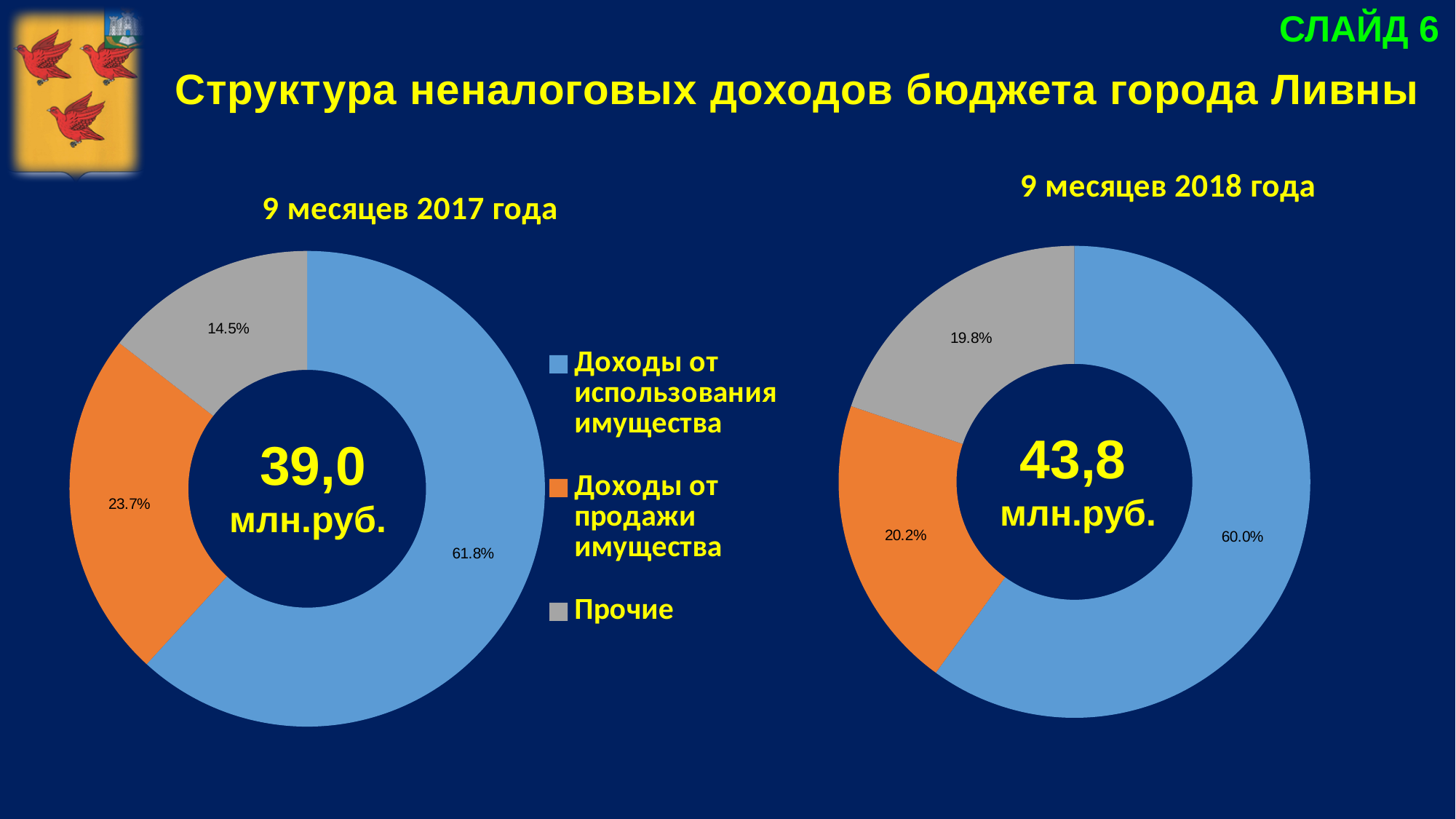
Which is larger: the share of "Прочие" in the 2017 chart or in the 2018 chart? 2018 In the chart for "9 месяцев 2018 года", what share is labelled for "Прочие"? 19.8% In the chart for "9 месяцев 2017 года", which category has the largest share? Доходы от использования имущества What total value is shown in the centre of the chart for "9 месяцев 2018 года"? 43,8 млн.руб. In the chart for "9 месяцев 2018 года", which category has the smallest share? Прочие In the chart for "9 месяцев 2018 года", what share is labelled for "Доходы от продажи имущества"? 20.2% How many categories does the legend list? 3 What type of chart is used on this slide? Pie (donut) chart In the chart for "9 месяцев 2017 года", what is the difference in percentage points between "Доходы от продажи имущества" and "Прочие"? 9.2 What total value is shown in the centre of the chart for "9 месяцев 2017 года"? 39,0 млн.руб. In the chart for "9 месяцев 2017 года", what share is labelled for "Доходы от использования имущества"? 61.8% In the chart for "9 месяцев 2017 года", what share is labelled for "Прочие"? 14.5%